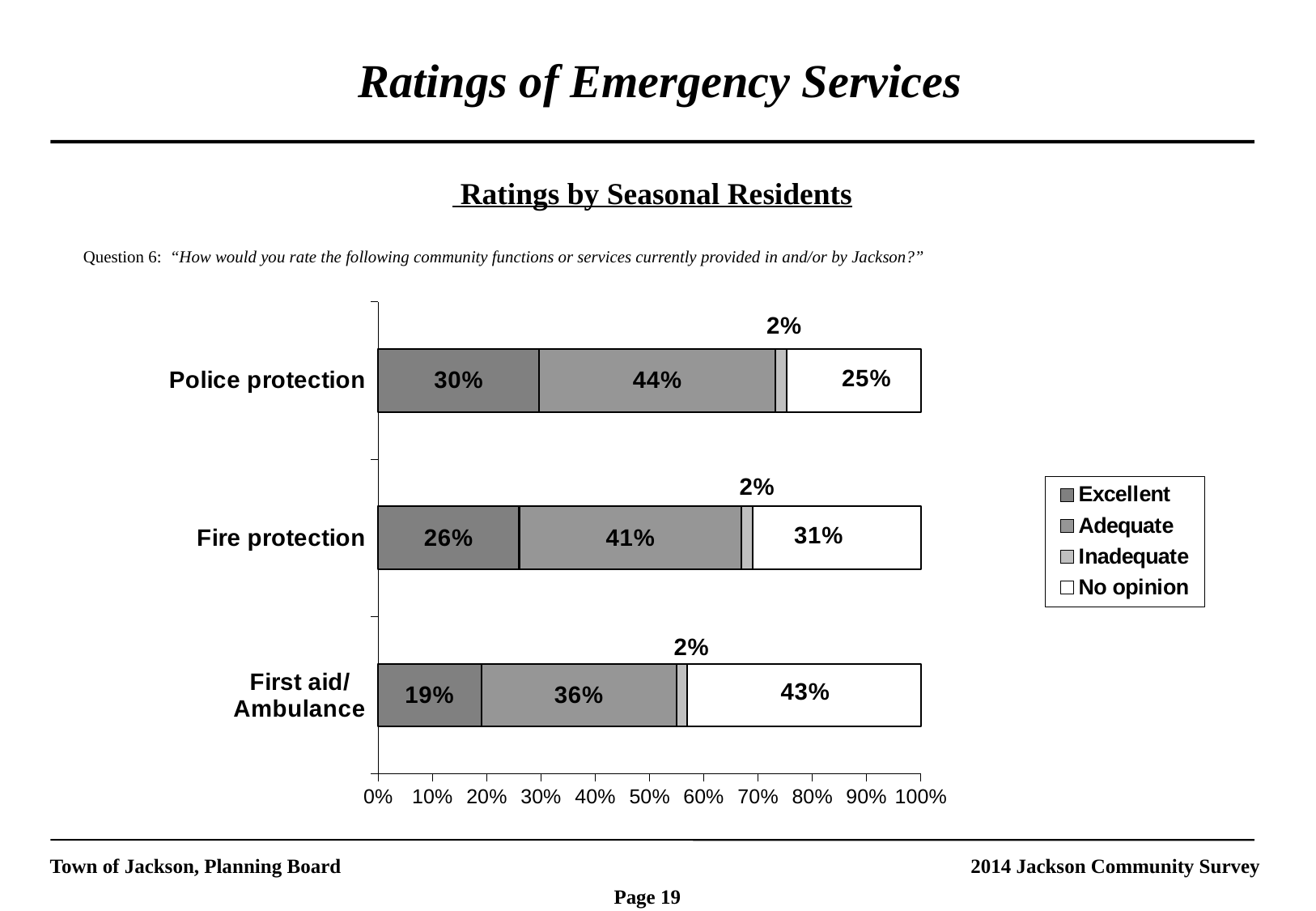
What percentage of seasonal residents had No opinion on First aid/Ambulance? 43% How much larger is the Adequate rating for Police protection than for First aid/Ambulance? 8% What is the subtitle above the chart? Ratings by Seasonal Residents How many services are shown on the chart? 3 What kind of chart is shown on the slide? Stacked bar chart Which service has the lowest No opinion share? Police protection What percentage of seasonal residents rated Police protection as Excellent? 30% Which has a larger No opinion share, Fire protection or Police protection? Fire protection How many rating categories does the legend list? 4 What is the Adequate rating for Fire protection? 41% What is the Inadequate rating for Fire protection? 2% Which service has the highest Excellent rating? Police protection